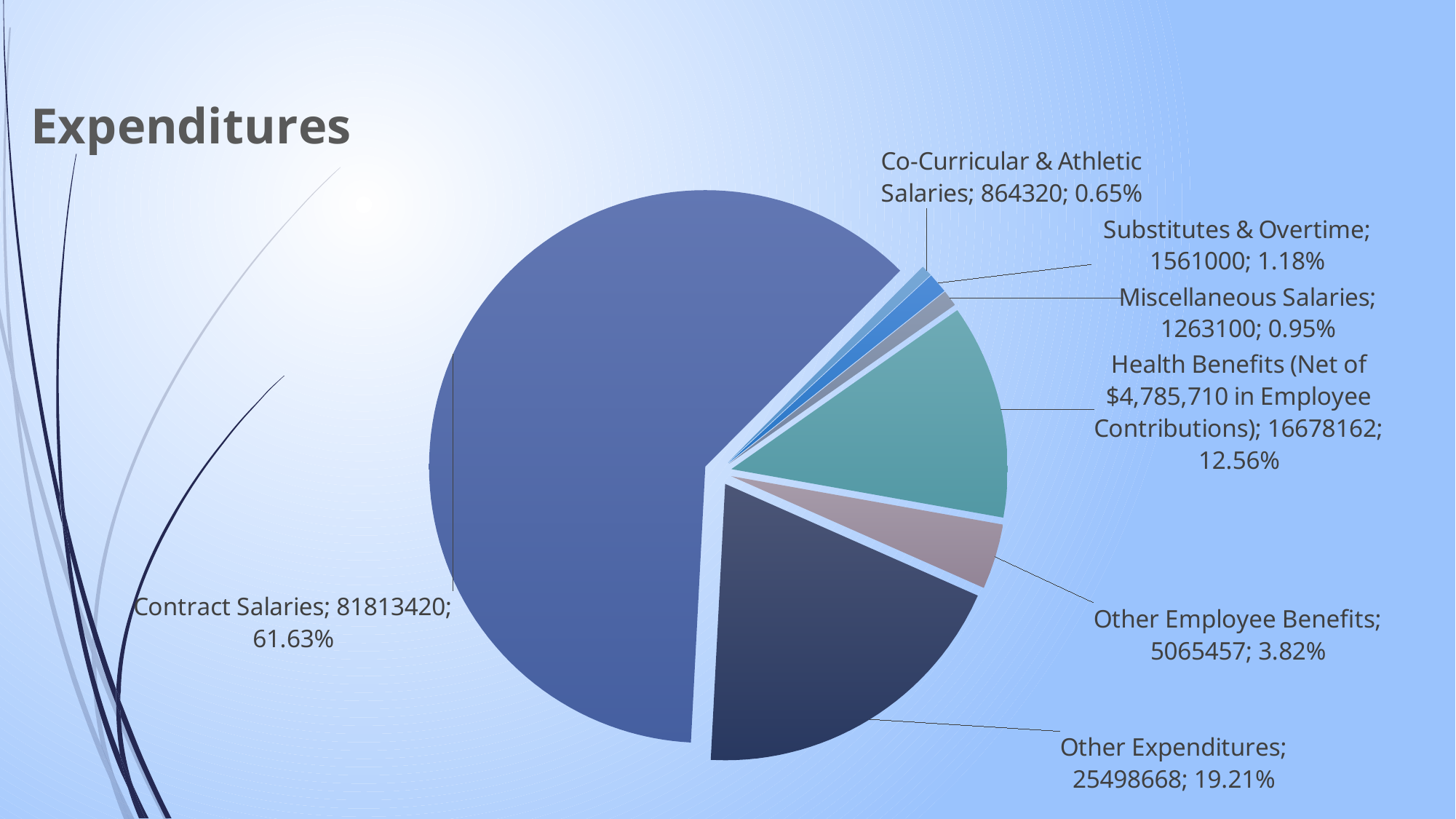
Which is larger, Substitutes & Overtime or Miscellaneous Salaries? Substitutes & Overtime What percentage share does Other Expenditures have? 19.21% What is the difference between the values for Other Expenditures and Health Benefits? 8820506 What percentage share does Co-Curricular & Athletic Salaries have? 0.65% How many slices does the pie chart have? 7 What is the value shown for Contract Salaries? 81813420 What is the value shown for Health Benefits (Net of $4,785,710 in Employee Contributions)? 16678162 Which category has the largest slice of the pie? Contract Salaries Which category has the smallest slice of the pie? Co-Curricular & Athletic Salaries What is the title of the slide? Expenditures What kind of chart is shown on the slide? pie chart What is the difference in percentage share between Contract Salaries and Other Expenditures? 42.42%